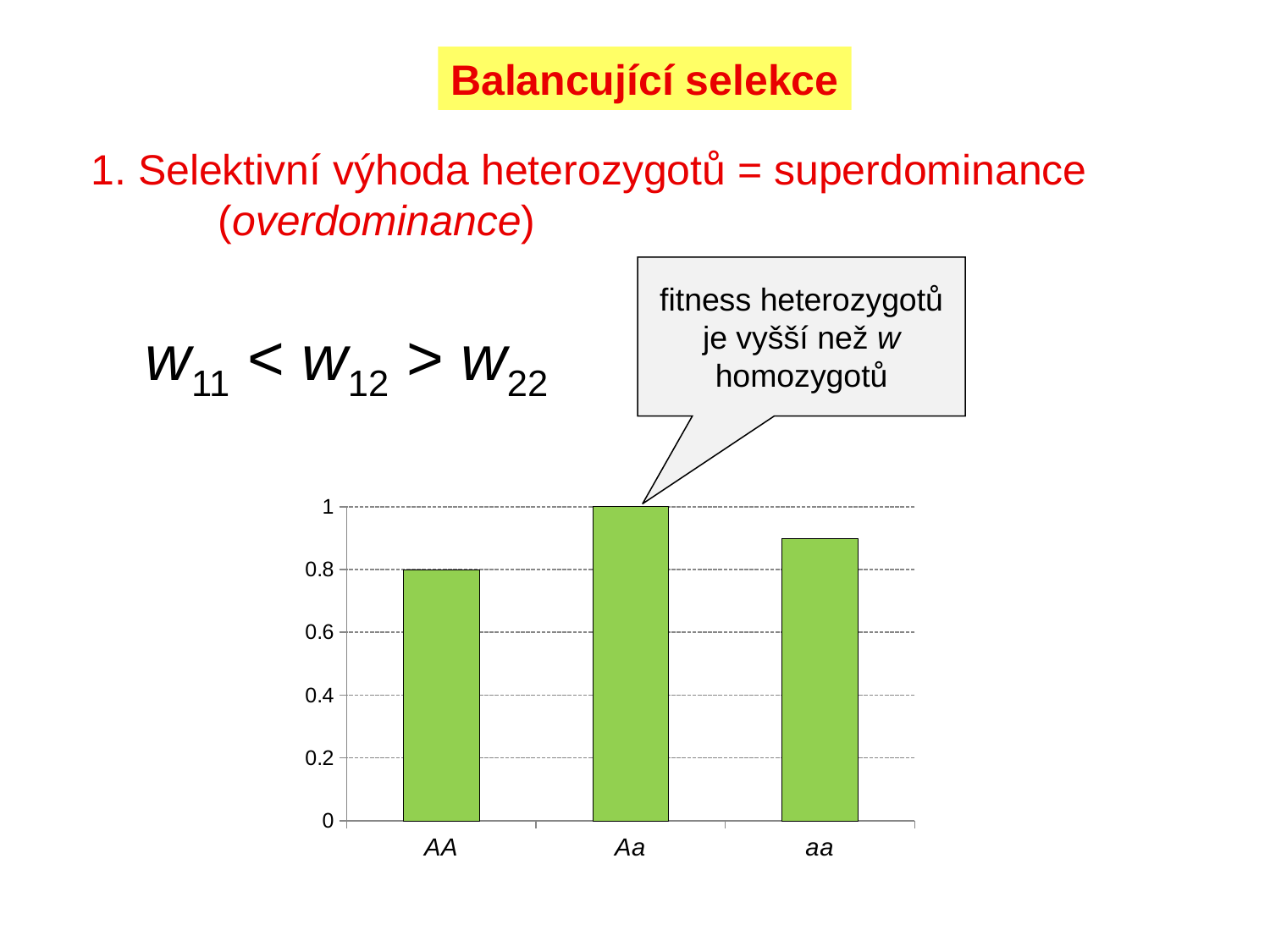
What kind of chart is shown on the slide? bar chart Which is larger, the value for AA or the value for aa? aa Is the value for aa greater or less than 0.8? greater What is the value for AA? 0.8 What colour are the bars in the chart? green What is the difference between the values for Aa and AA? 0.2 What is the highest value labelled on the y axis? 1 Which category has the highest bar? Aa Is the value for aa greater or less than 1? less Which category has the lowest bar? AA How many categories are shown on the x axis? 3